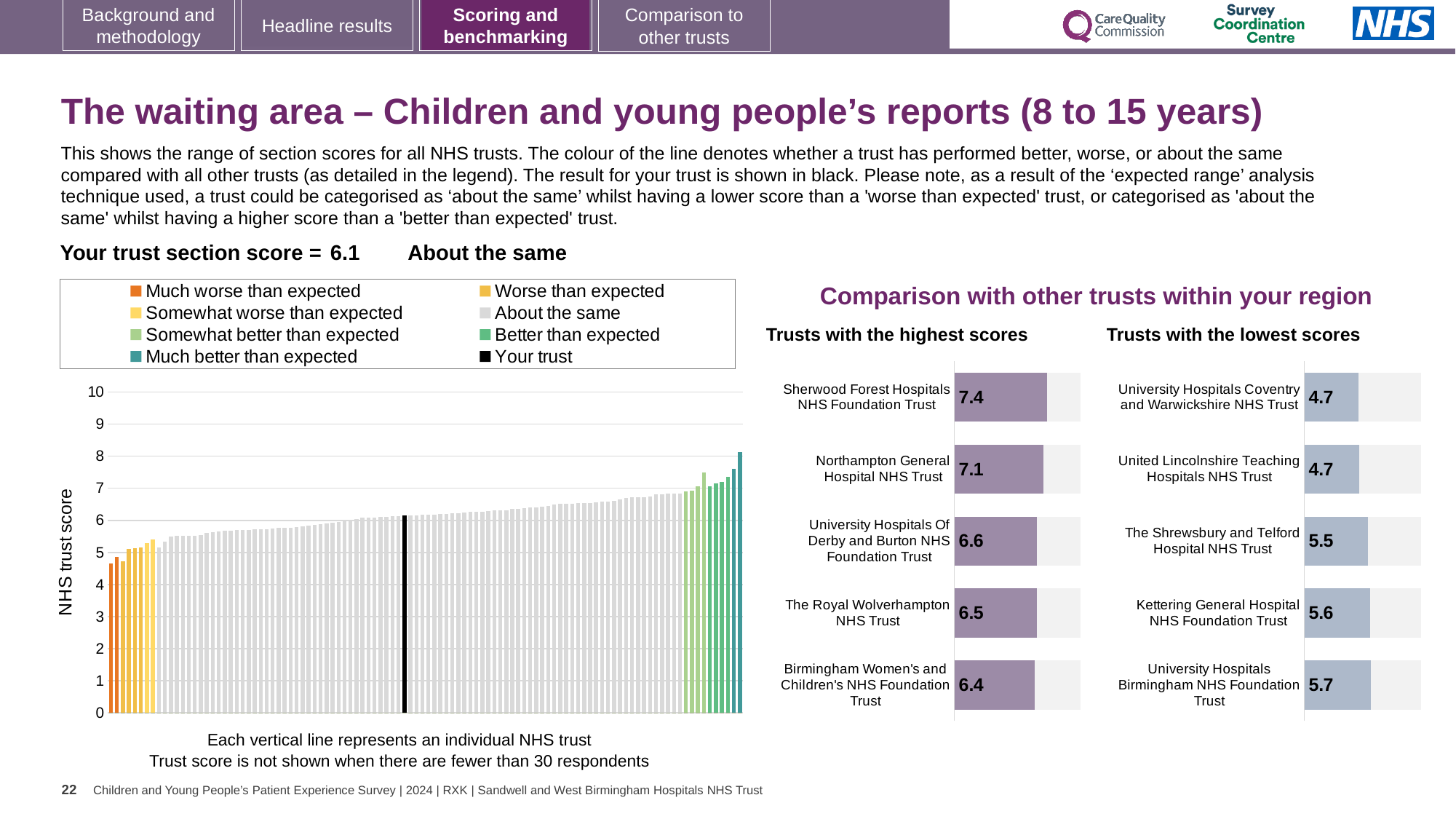
In the 'Trusts with the lowest scores' chart, which trust has the highest score shown? University Hospitals Birmingham NHS Foundation Trust In the NHS trust score chart on the left, do the trust scores rise or fall from left to right? rise How many entries does the legend above the NHS trust score chart list? 8 In the 'Trusts with the highest scores' chart, what is the difference between the scores of Sherwood Forest Hospitals NHS Foundation Trust and The Royal Wolverhampton NHS Trust? 0.9 In the 'Trusts with the highest scores' chart, what is the score for Sherwood Forest Hospitals NHS Foundation Trust? 7.4 In the 'Trusts with the highest scores' chart, what is the score for Northampton General Hospital NHS Trust? 7.1 In the 'Trusts with the lowest scores' chart, what is the difference between the scores of University Hospitals Birmingham NHS Foundation Trust and University Hospitals Coventry and Warwickshire NHS Trust? 1.0 In the 'Trusts with the lowest scores' chart, what is the score for The Shrewsbury and Telford Hospital NHS Trust? 5.5 In the 'Trusts with the lowest scores' chart, how many trusts are listed? 5 In the 'Trusts with the highest scores' chart, which trust has the lowest score shown? Birmingham Women's and Children's NHS Foundation Trust In the 'Trusts with the lowest scores' chart, is the score for Kettering General Hospital NHS Foundation Trust larger or smaller than the score for United Lincolnshire Teaching Hospitals NHS Trust? larger In the NHS trust score chart on the left, what is the section score for your trust (the black bar)? 6.1